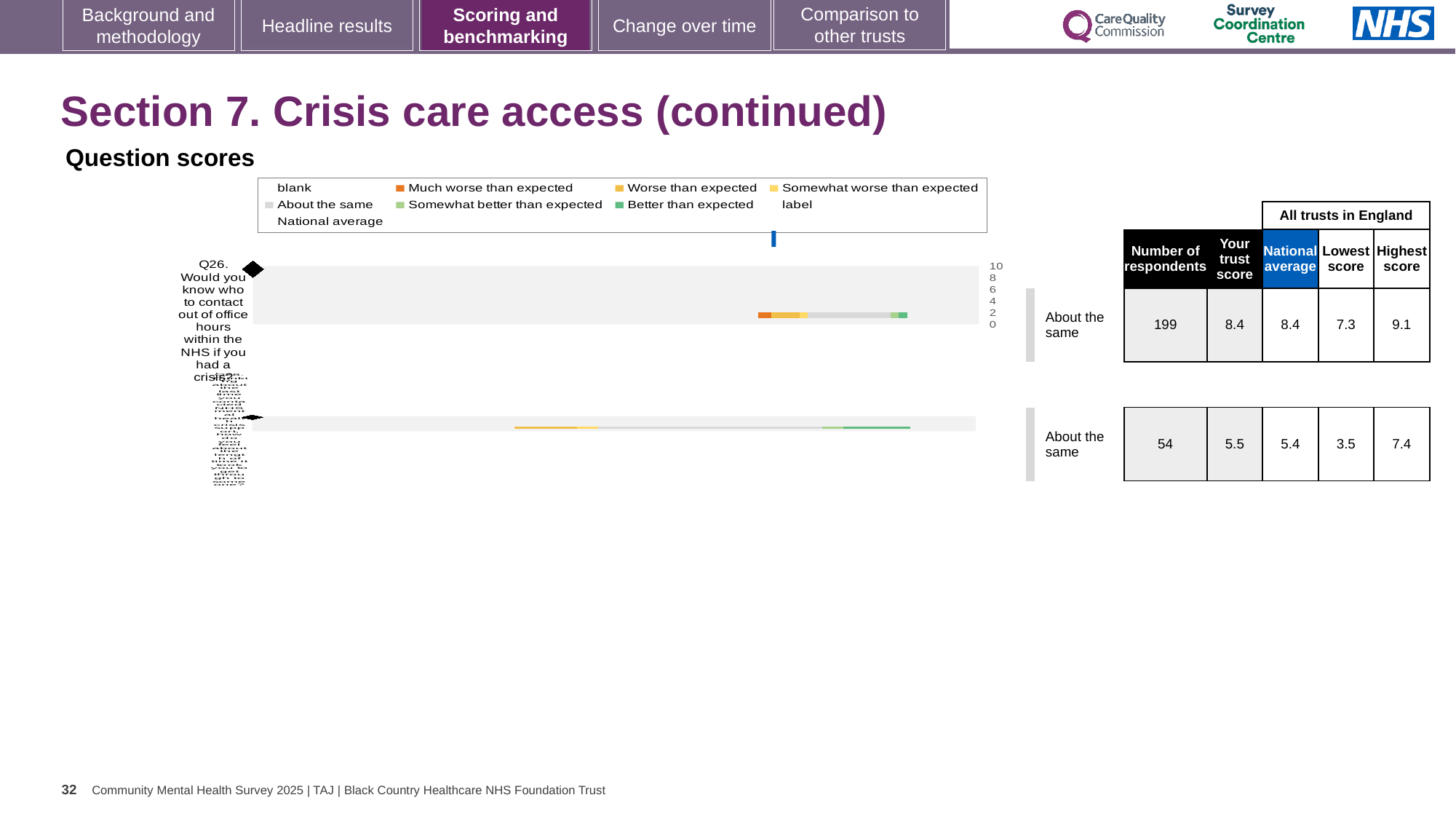
According to the table beside the chart, what is the number of respondents for Q26? 199 What is the difference between the highest and lowest scores in England for Q26? 1.8 For the second question row in the chart, is the trust score or the national average higher? trust score What is the maximum value shown on the score axis of the question scores chart? 10 According to the table beside the chart, what is the lowest score among all trusts in England for Q26? 7.3 According to the table beside the chart, what is the highest score among all trusts in England for Q26? 9.1 What benchmark category is shown for Q26 next to the chart? About the same What kind of chart is used to show the question scores on this slide? bar chart In the question scores chart legend, which colour represents 'Much worse than expected'? orange According to the table beside the chart, what is the trust's score for Q26? 8.4 How many question bars are plotted in the question scores chart? 2 For the second question row in the chart, what is the national average score shown in the table? 5.4